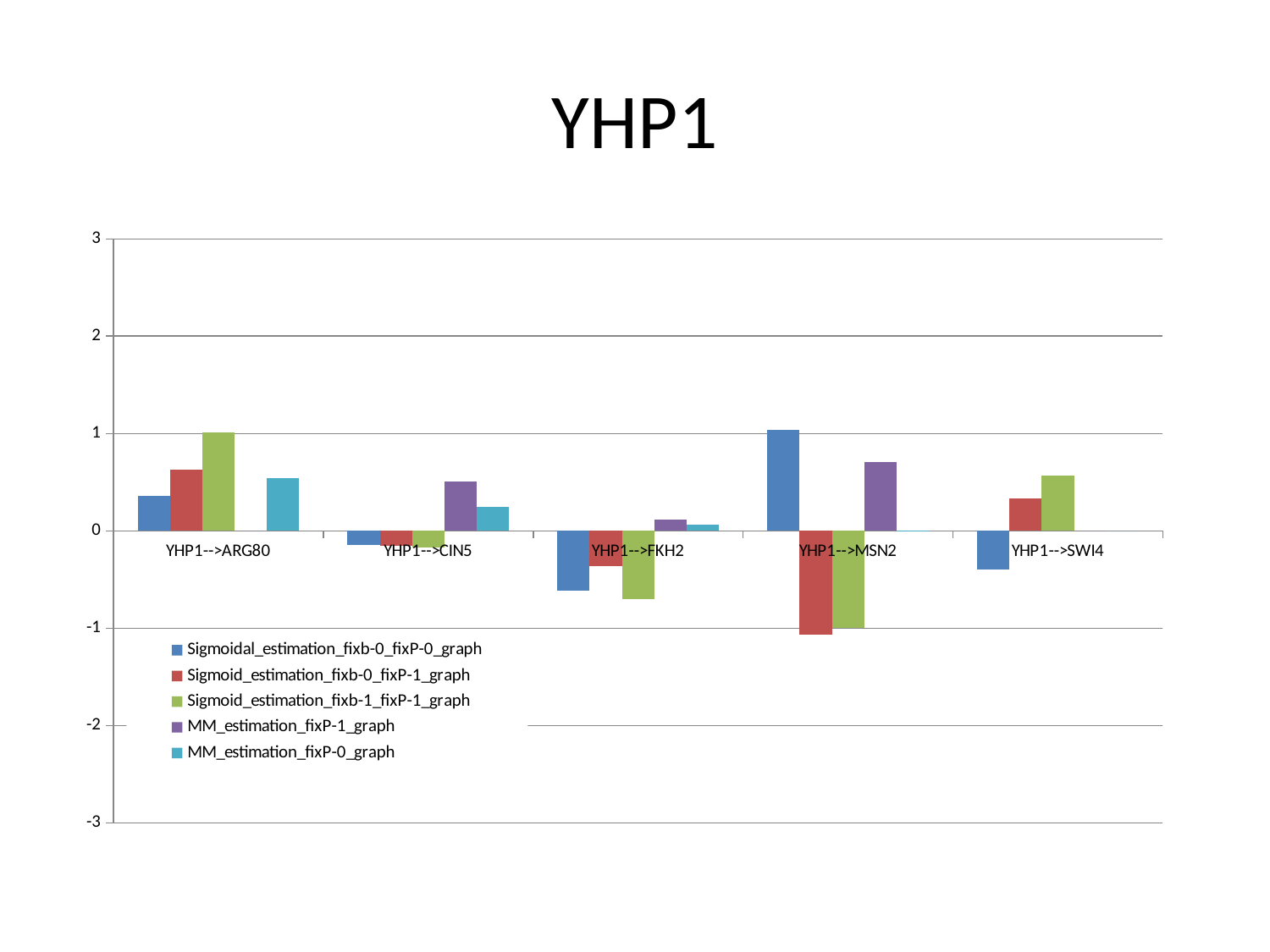
For YHP1-->ARG80, which series has the larger value: Sigmoid_estimation_fixb-1_fixP-1_graph or Sigmoidal_estimation_fixb-0_fixP-0_graph? Sigmoid_estimation_fixb-1_fixP-1_graph Is the value of Sigmoidal_estimation_fixb-0_fixP-0_graph for YHP1-->MSN2 greater or less than 0.5? greater What is the title of the chart? YHP1 For MM_estimation_fixP-1_graph, which is larger: the value for YHP1-->MSN2 or for YHP1-->CIN5? YHP1-->MSN2 How many categories are shown on the x axis? 5 How many series does the legend list? 5 Which category has the lowest value for Sigmoid_estimation_fixb-1_fixP-1_graph? YHP1-->MSN2 Is the value of MM_estimation_fixP-1_graph for YHP1-->CIN5 greater or less than 1? less Which category has the lowest value for Sigmoidal_estimation_fixb-0_fixP-0_graph? YHP1-->FKH2 What kind of chart is shown on the slide? bar chart Is the value of Sigmoid_estimation_fixb-0_fixP-1_graph for YHP1-->MSN2 greater or less than -0.5? less Which category has the highest value for Sigmoid_estimation_fixb-1_fixP-1_graph? YHP1-->ARG80